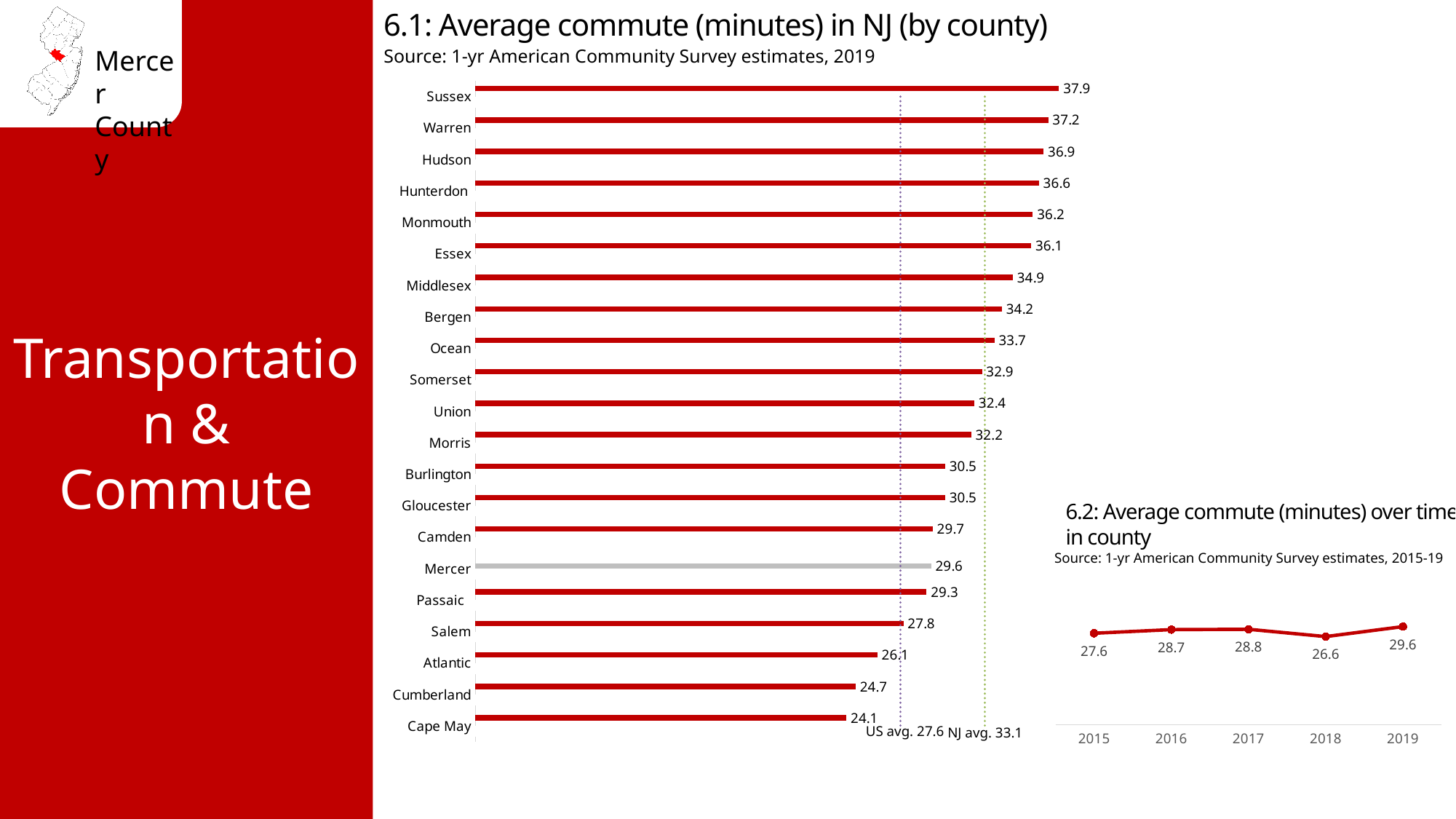
In chart 6.1 (Average commute in NJ by county), what is the difference between the average commute for Sussex and Cape May? 13.8 In chart 6.1 (Average commute in NJ by county), which county has the highest average commute? Sussex In chart 6.2 (Average commute over time in county), which year had the highest average commute? 2019 In chart 6.1 (Average commute in NJ by county), how many counties are plotted? 21 In chart 6.1 (Average commute in NJ by county), what is the average commute for Hudson? 36.9 What type of chart is chart 6.1 (Average commute in NJ by county)? Bar chart In chart 6.1 (Average commute in NJ by county), which has a longer average commute, Bergen or Ocean? Bergen In chart 6.1 (Average commute in NJ by county), what is the NJ average commute shown by the dotted reference line? 33.1 In chart 6.2 (Average commute over time in county), what was the average commute in 2018? 26.6 In chart 6.2 (Average commute over time in county), what is the difference between the 2019 and 2015 values? 2.0 In chart 6.1 (Average commute in NJ by county), which county has the lowest average commute? Cape May In chart 6.1 (Average commute in NJ by county), what is the average commute for Mercer? 29.6